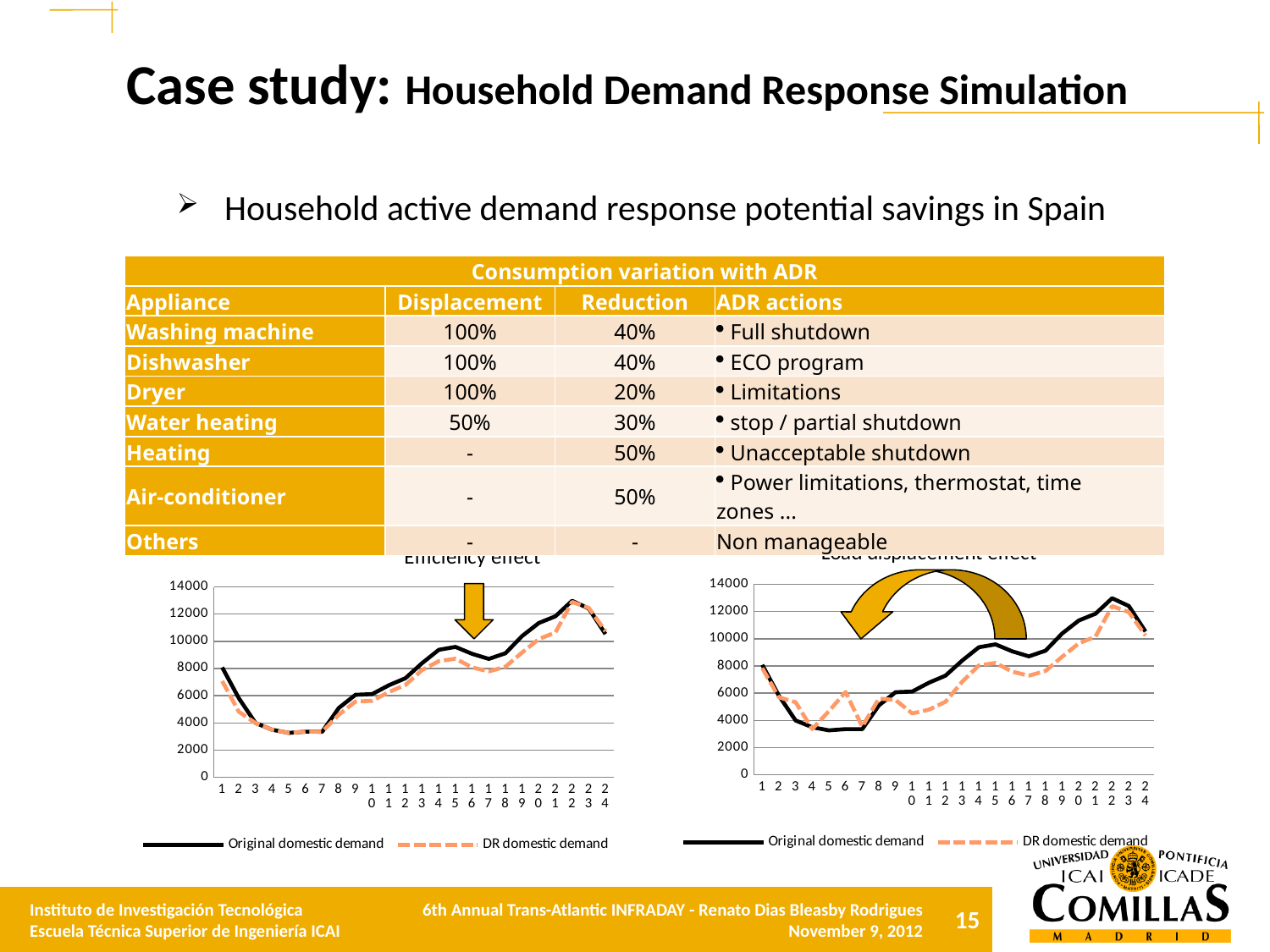
In the 'Efficiency effect' chart, does the Original domestic demand rise or fall from point 1 to point 5? Fall What are the two series named in the legend of the 'Efficiency effect' chart? Original domestic demand and DR domestic demand In the 'Efficiency effect' chart, is the Original domestic demand value at point 5 greater or less than 4000? less How many series does the legend of the 'Efficiency effect' chart list? 2 What kind of chart is the 'Efficiency effect' chart on the left? Line chart How many points are plotted along the x axis of the 'Efficiency effect' chart? 24 In the chart on the right of the slide, which series is drawn with a dashed line? DR domestic demand In the chart on the right of the slide, is the Original domestic demand value at point 7 greater or less than 4000? less In the 'Efficiency effect' chart, which series has the larger value at point 15, Original domestic demand or DR domestic demand? Original domestic demand In the 'Efficiency effect' chart, does the Original domestic demand rise or fall from point 7 to point 21? Rise In the chart on the right of the slide, which series has the larger value at point 6, Original domestic demand or DR domestic demand? DR domestic demand